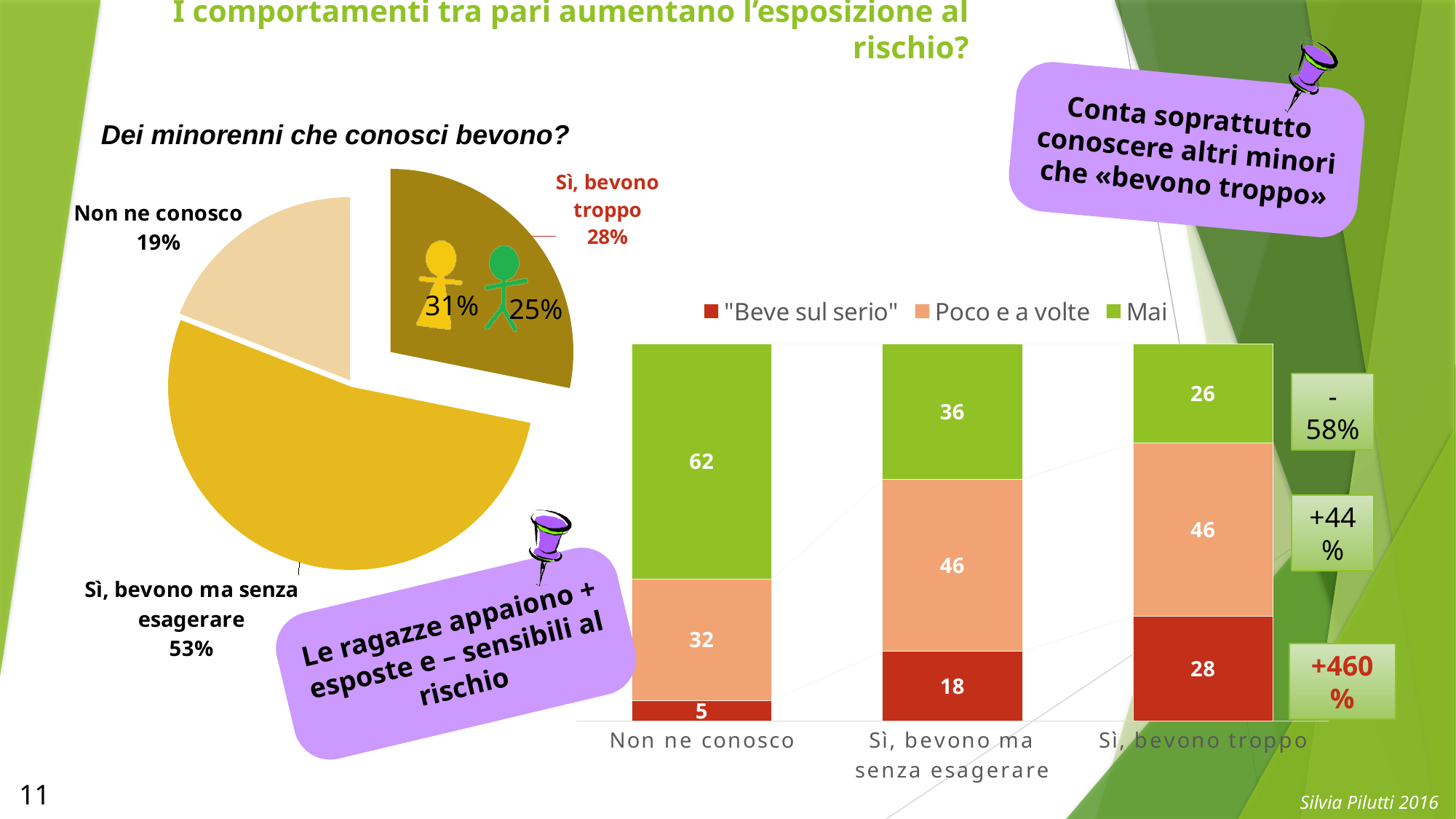
In the stacked bar chart on the right, what is the value of '"Beve sul serio"' for 'Sì, bevono troppo'? 28 In the stacked bar chart on the right, which category has the highest '"Beve sul serio"' value? Sì, bevono troppo In the pie chart 'Dei minorenni che conosci bevono?', how many slices are there? 3 In the pie chart 'Dei minorenni che conosci bevono?', which slice is the largest? Sì, bevono ma senza esagerare In the stacked bar chart on the right, what is the total of the 'Sì, bevono ma senza esagerare' bar? 100 In the pie chart 'Dei minorenni che conosci bevono?', what share is labelled 'Non ne conosco'? 19% In the stacked bar chart on the right, how many series does the legend list? 3 In the pie chart 'Dei minorenni che conosci bevono?', which slice is the smallest? Non ne conosco In the pie chart 'Dei minorenni che conosci bevono?', what is the difference between the 'Sì, bevono ma senza esagerare' slice and the 'Sì, bevono troppo' slice? 25% In the stacked bar chart on the right, what is the value of 'Mai' for 'Non ne conosco'? 62 What type of chart is the one on the right of the slide? stacked bar chart In the stacked bar chart on the right, does the '"Beve sul serio"' value rise or fall from 'Non ne conosco' to 'Sì, bevono troppo'? rise